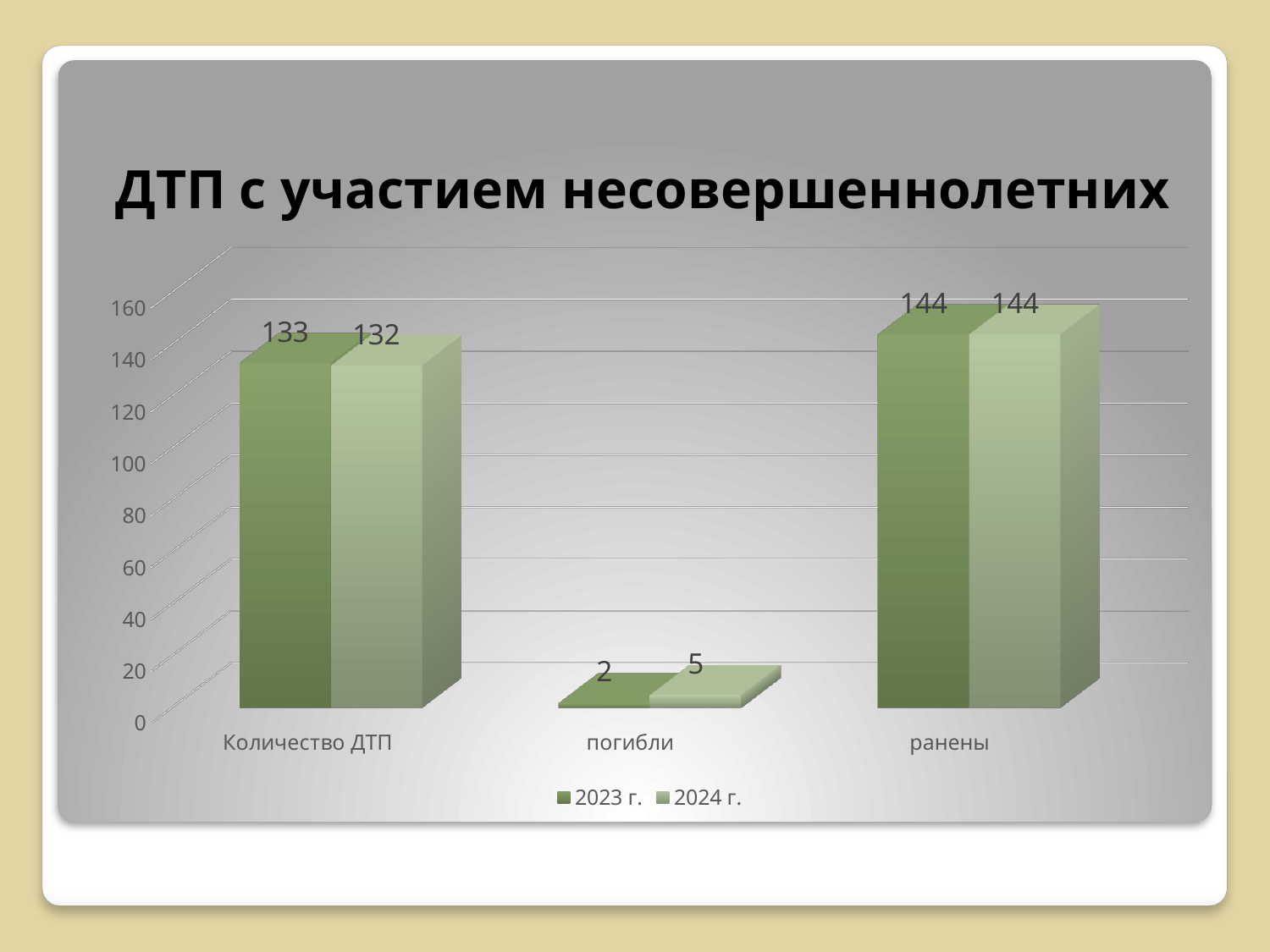
What is the value for 2024 г. in the погибли category? 5 Which category has the lowest value for 2023 г.? погибли What is the difference between the 2024 г. and 2023 г. values in the погибли category? 3 Which category has the highest value for 2024 г.? ранены Which is larger in the погибли category: the value for 2023 г. or for 2024 г.? 2024 г. What is the value for 2023 г. in the Количество ДТП category? 133 How many series does the legend list? 2 What is the title of the chart? ДТП с участием несовершеннолетних What is the value for 2023 г. in the погибли category? 2 What is the value for 2024 г. in the Количество ДТП category? 132 What is the value for 2024 г. in the ранены category? 144 How many categories are shown on the x axis? 3